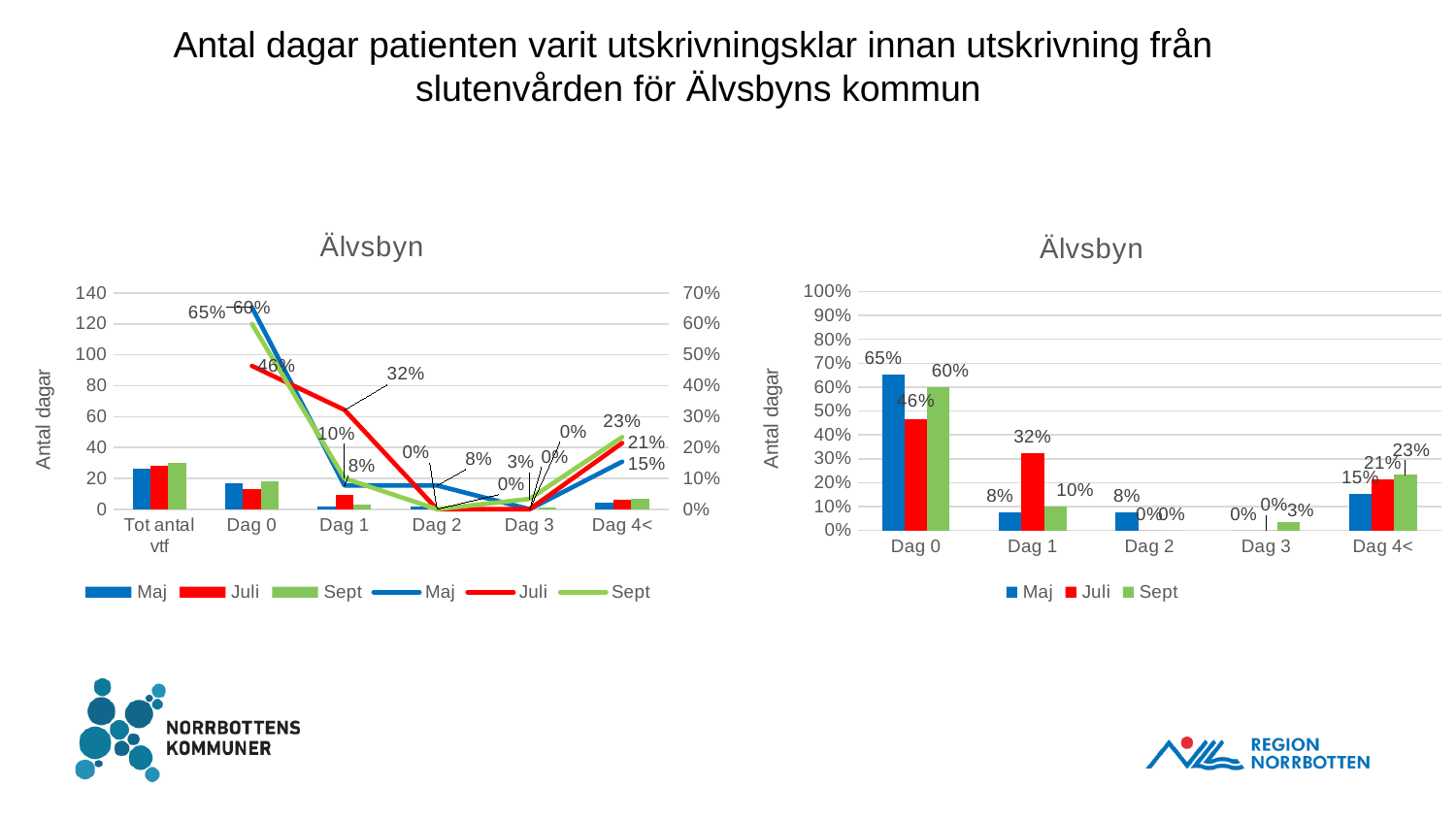
On the right chart, what is the value for Sept at Dag 4<? 23% What is the title of the left chart? Älvsbyn On the right chart, which category has the highest value for Juli? Dag 0 On the right chart, how many series does the legend list? 3 What kind of chart is the right chart? bar chart On the left chart, is the bar value for Maj at Tot antal vtf greater or less than 20? greater On the left chart, is the bar value for Juli at Dag 1 greater or less than 20? less On the right chart, what is the value for Juli at Dag 1? 32% On the right chart, which is larger at Dag 1: Maj or Sept? Sept On the right chart, what is the difference between Maj and Juli at Dag 0? 19% On the right chart, how many categories are shown on the x axis? 5 On the right chart, what is the value for Maj at Dag 0? 65%